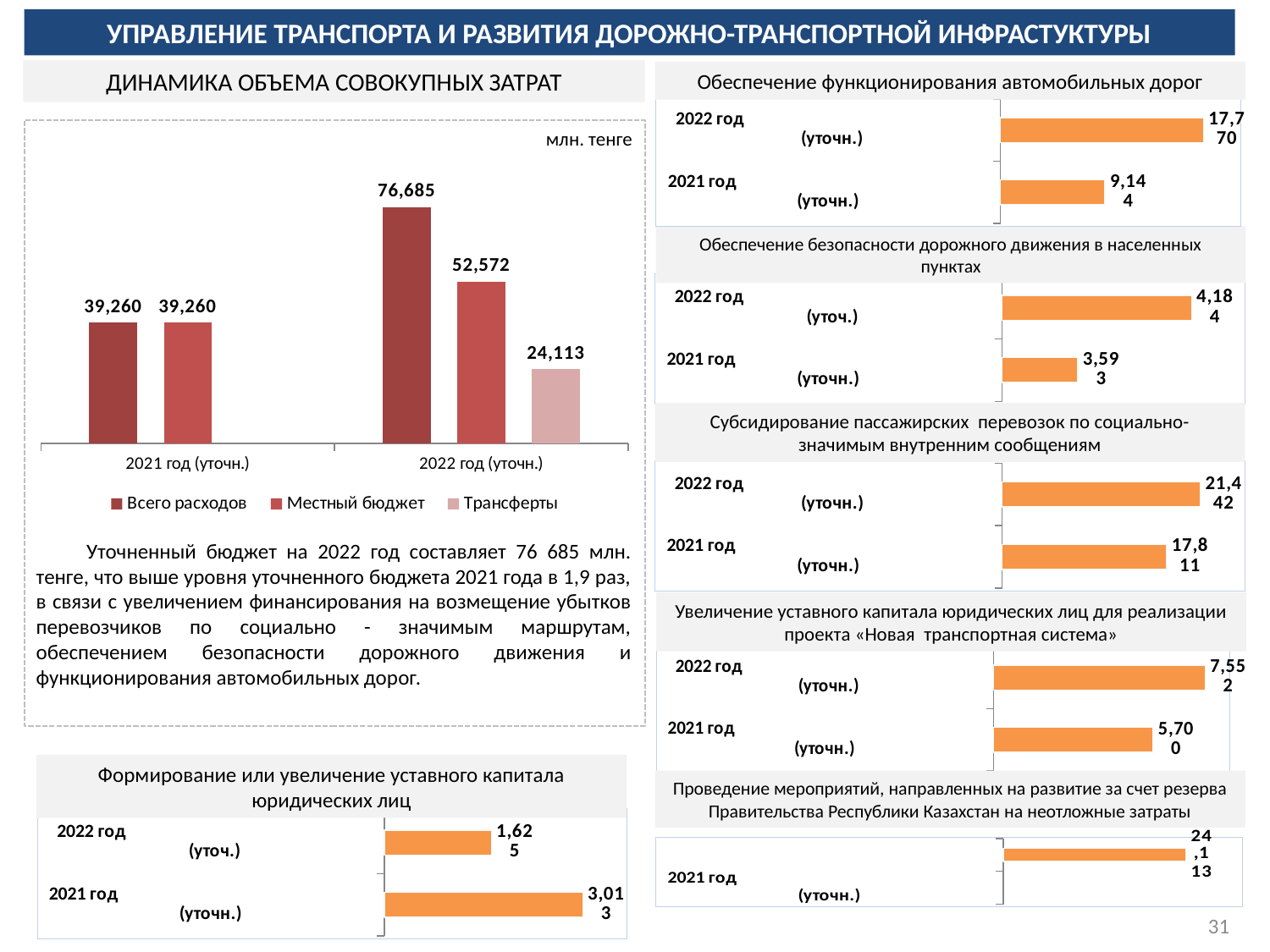
In the chart 'ДИНАМИКА ОБЪЕМА СОВОКУПНЫХ ЗАТРАТ', how many series does the legend list? 3 In the chart 'Формирование или увеличение уставного капитала юридических лиц', what is the value for 2021 год (уточн.)? 3,013 In the chart 'ДИНАМИКА ОБЪЕМА СОВОКУПНЫХ ЗАТРАТ', which series has the lowest value for 2022 год (уточн.)? Трансферты In the chart 'Увеличение уставного капитала юридических лиц для реализации проекта «Новая транспортная система»', what is the value for 2021 год (уточн.)? 5,700 In the chart 'ДИНАМИКА ОБЪЕМА СОВОКУПНЫХ ЗАТРАТ', what is the value of 'Всего расходов' for 2022 год (уточн.)? 76,685 In the chart 'Обеспечение функционирования автомобильных дорог', what is the value for 2022 год (уточн.)? 17,770 In the chart 'Обеспечение безопасности дорожного движения в населенных пунктах', which year has the larger value, 2022 год or 2021 год? 2022 год What type of chart is 'ДИНАМИКА ОБЪЕМА СОВОКУПНЫХ ЗАТРАТ'? Bar chart In the chart 'ДИНАМИКА ОБЪЕМА СОВОКУПНЫХ ЗАТРАТ', what is the value of 'Трансферты' for 2022 год (уточн.)? 24,113 In the chart 'ДИНАМИКА ОБЪЕМА СОВОКУПНЫХ ЗАТРАТ', what is the difference between 'Всего расходов' in 2022 год (уточн.) and in 2021 год (уточн.)? 37,425 In the chart 'ДИНАМИКА ОБЪЕМА СОВОКУПНЫХ ЗАТРАТ', what is the value of 'Местный бюджет' for 2021 год (уточн.)? 39,260 In the chart 'ДИНАМИКА ОБЪЕМА СОВОКУПНЫХ ЗАТРАТ', what unit is shown in the top right corner? млн. тенге